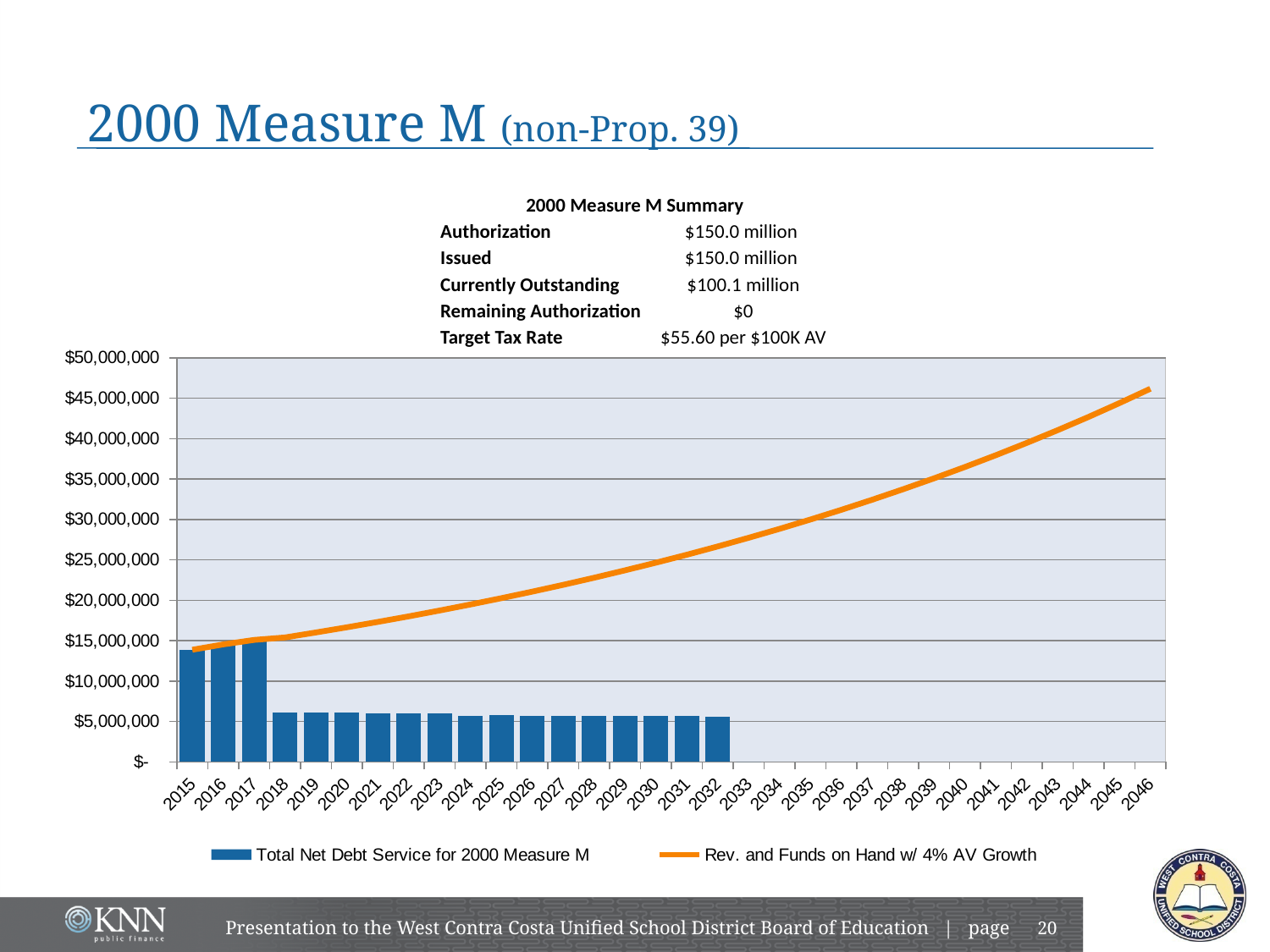
How many series does the chart legend list? 2 How many years are shown on the x axis of the chart? 32 Which series is drawn as an orange line? Rev. and Funds on Hand w/ 4% AV Growth What is the last year that has a bar for Total Net Debt Service for 2000 Measure M? 2032 Is the Rev. and Funds on Hand w/ 4% AV Growth value for 2040 greater or less than $35,000,000? greater Is the Rev. and Funds on Hand w/ 4% AV Growth value for 2020 greater or less than $15,000,000? greater Does the Rev. and Funds on Hand w/ 4% AV Growth line rise or fall from 2015 to 2046? Rises Is the Rev. and Funds on Hand w/ 4% AV Growth value for 2046 greater or less than $45,000,000? greater What kind of chart is shown on the slide? A combined bar and line chart Which is larger, the Total Net Debt Service bar for 2016 or the bar for 2025? 2016